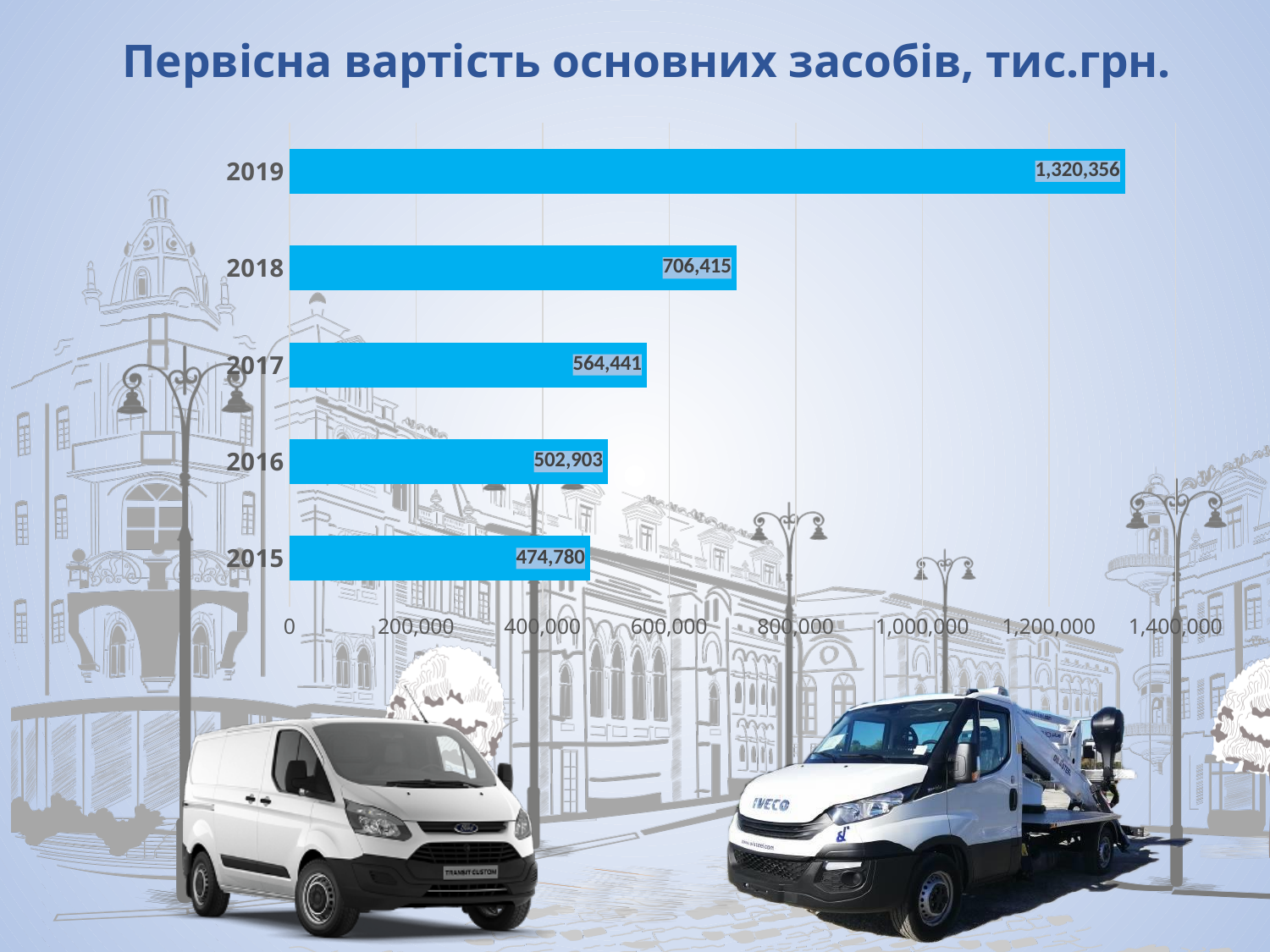
Which year has the lowest value? 2015 Which year has the highest value? 2019 What is the value for 2015? 474,780 Do the values rise or fall from 2015 to 2019? rise What is the value for 2017? 564,441 How many years are shown in the chart? 5 Is the value for 2018 greater or less than 800,000? less Which is larger, the value for 2018 or the value for 2017? 2018 What is the difference between the values for 2019 and 2018? 613,941 What kind of chart is shown on the slide? bar chart What is the value for 2019? 1,320,356 What is the difference between the values for 2016 and 2015? 28,123